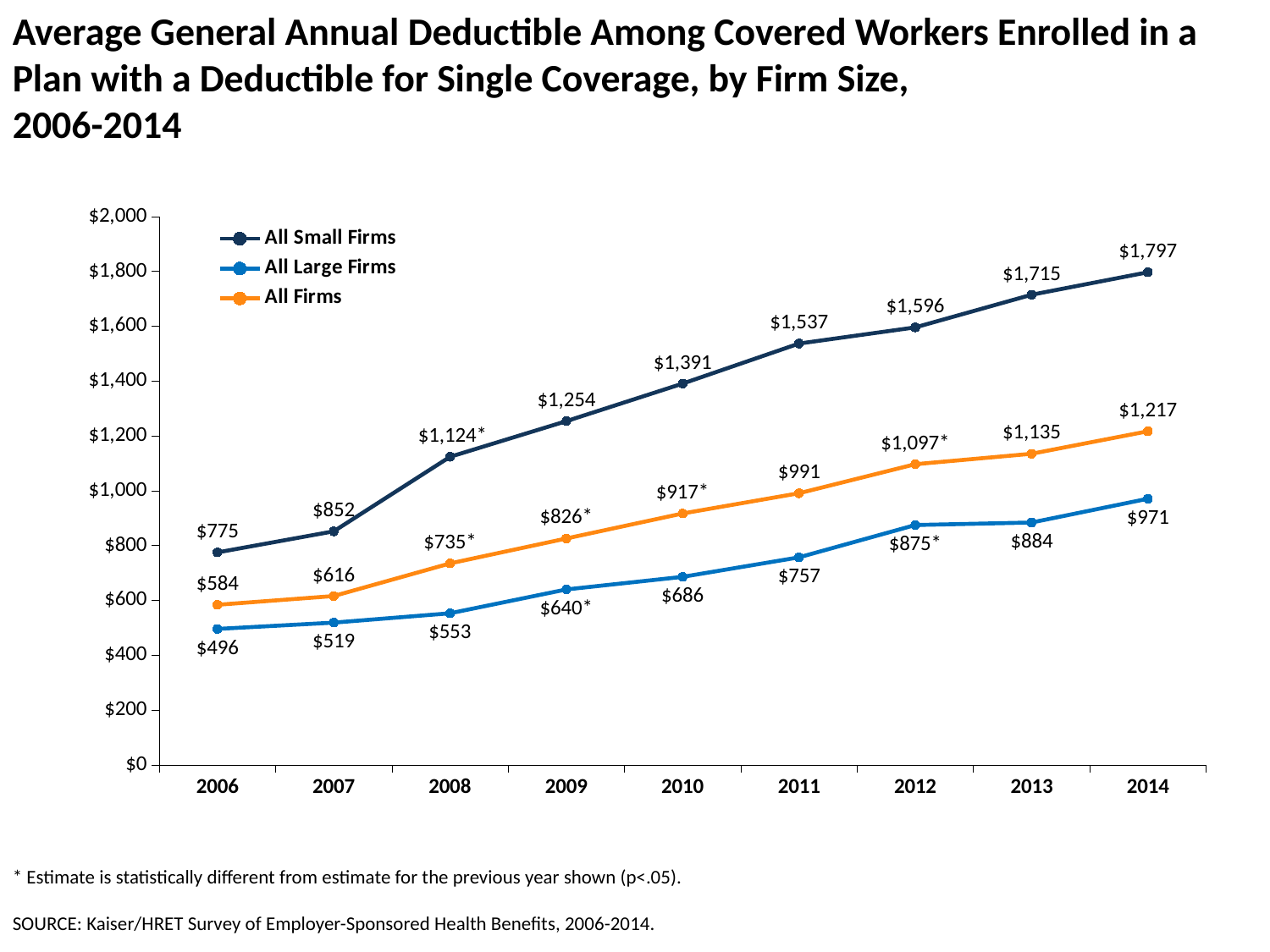
Does the All Large Firms deductible rise or fall from 2006 to 2014? Rise What is the average deductible for All Large Firms in 2011? $757 In which year is the All Small Firms deductible highest? 2014 What is the difference between the All Small Firms and All Large Firms deductibles in 2014? $826 What is the average deductible for All Small Firms in 2014? $1,797 Which is larger in 2010: the All Firms deductible or the All Large Firms deductible? All Firms In which year is the All Firms deductible lowest? 2006 What is the average deductible for All Firms in 2012? $1,097 How many years are shown on the x axis? 9 What is the average deductible for All Large Firms in 2006? $496 What kind of chart is this? Line chart How many series does the legend list? 3